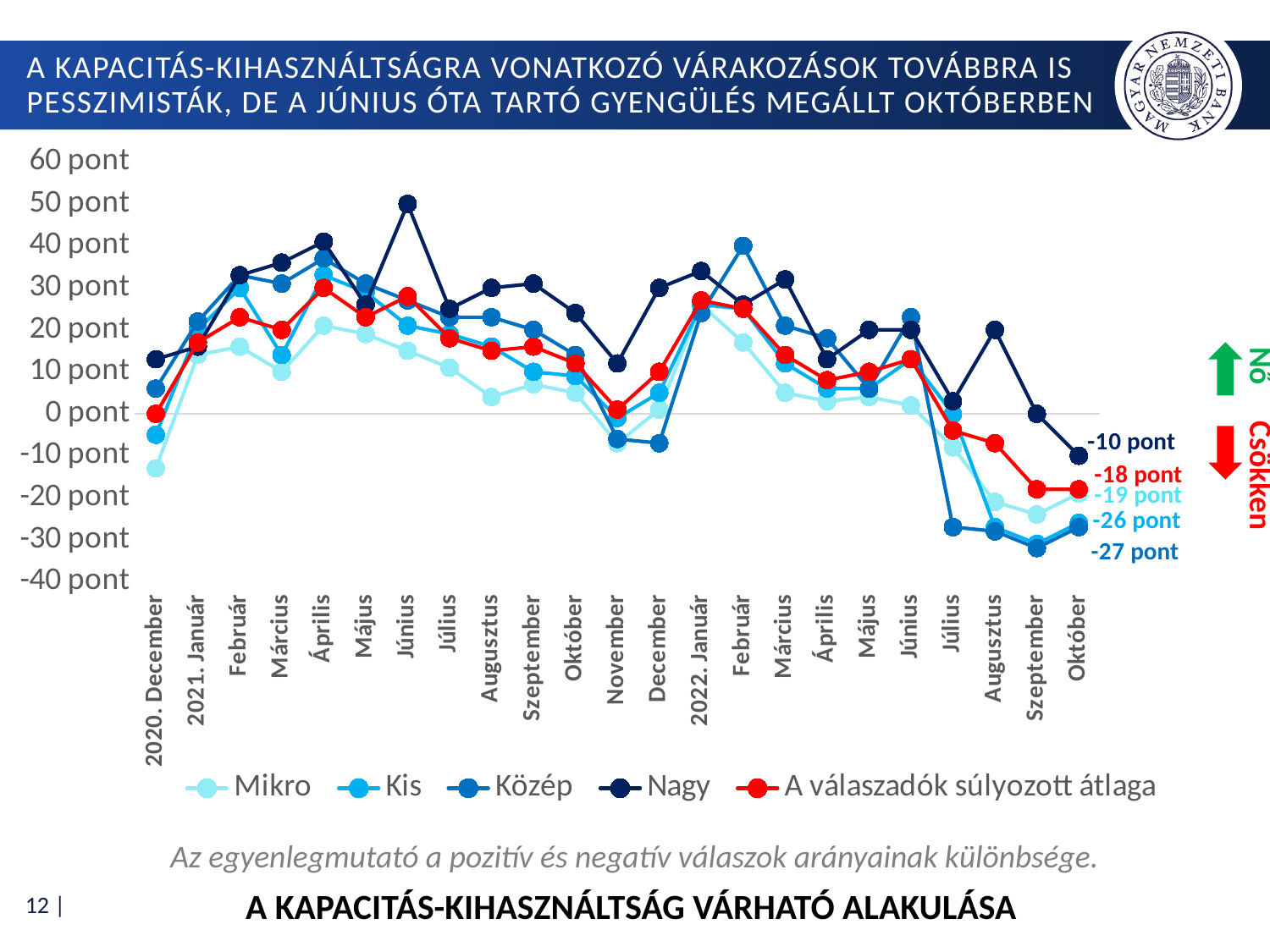
Which is larger in 2021 Június, the value for Nagy or the value for Mikro? Nagy How many series does the legend list? 5 What is the value for Kis in 2022 Október? -26 pont What is the value for Nagy in 2022 Október? -10 pont Is the value for Nagy in 2021 Június greater or less than 40 pont? greater What kind of chart is shown on the slide? Line chart What is the value for Mikro in 2022 Október? -19 pont Which series has the lowest value in 2022 Október? Közép What is the value for A válaszadók súlyozott átlaga in 2022 Október? -18 pont Which series has the highest value in 2022 Október? Nagy What is the value for Közép in 2022 Október? -27 pont What is the difference between the Nagy and Közép values in 2022 Október? 17 pont